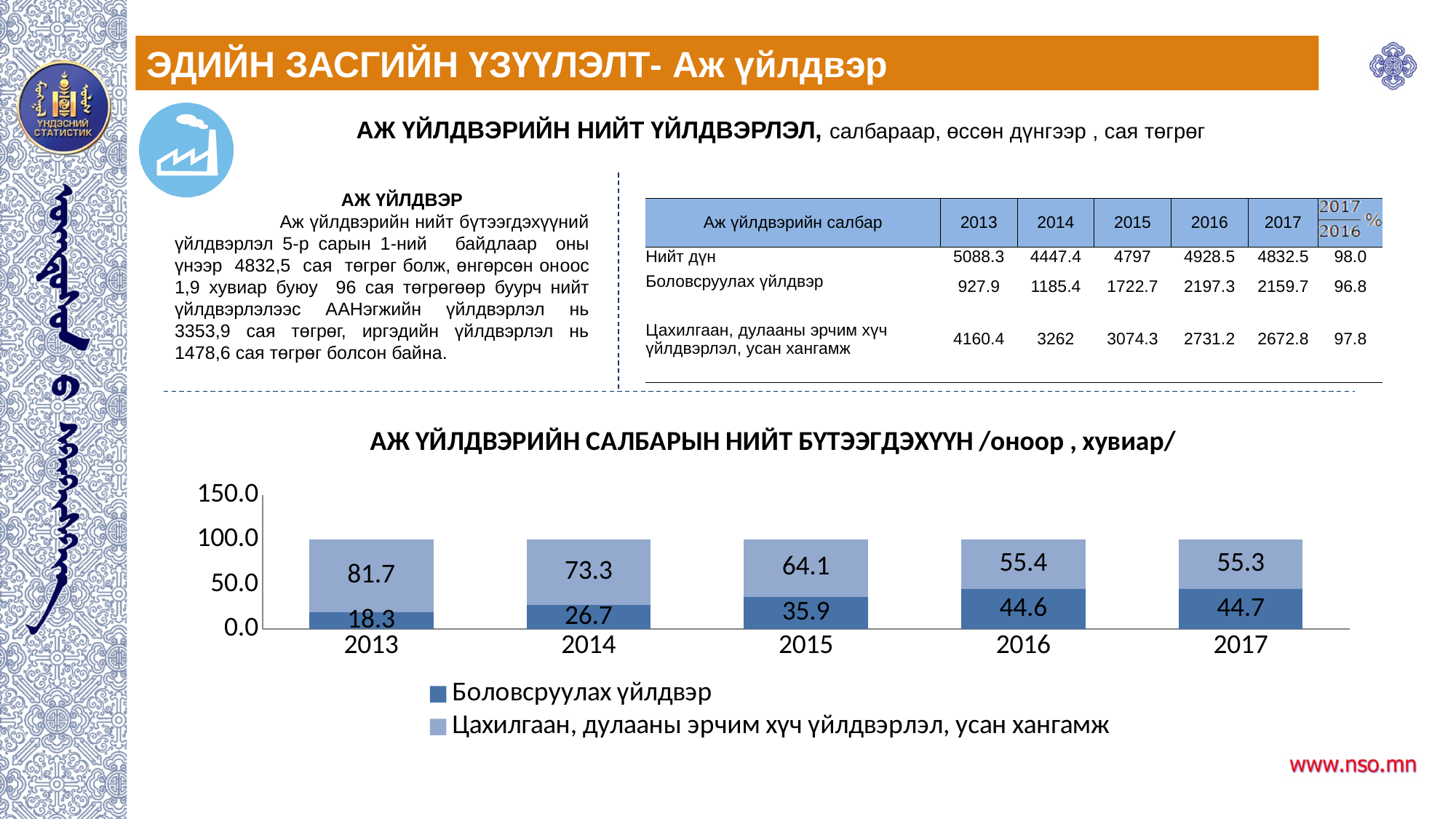
What is the value for Цахилгаан, дулааны эрчим хүч үйлдвэрлэл, усан хангамж in 2015? 64.1 Which is larger in 2016: the value for Боловсруулах үйлдвэр or the value for Цахилгаан, дулааны эрчим хүч үйлдвэрлэл, усан хангамж? Цахилгаан, дулааны эрчим хүч үйлдвэрлэл, усан хангамж What is the value for Боловсруулах үйлдвэр in 2017? 44.7 In which year is the value for Цахилгаан, дулааны эрчим хүч үйлдвэрлэл, усан хангамж the highest? 2013 What type of chart is shown on the slide? Stacked bar chart What is the difference between the Цахилгаан, дулааны эрчим хүч үйлдвэрлэл, усан хангамж value and the Боловсруулах үйлдвэр value in 2014? 46.6 Does the value for Боловсруулах үйлдвэр rise or fall from 2013 to 2017? Rise In which year is the value for Боловсруулах үйлдвэр the lowest? 2013 What is the total of the stacked bar for 2015? 100.0 How many series does the chart legend list? 2 What is the value for Боловсруулах үйлдвэр in 2013? 18.3 How many years are shown on the x axis of the chart? 5